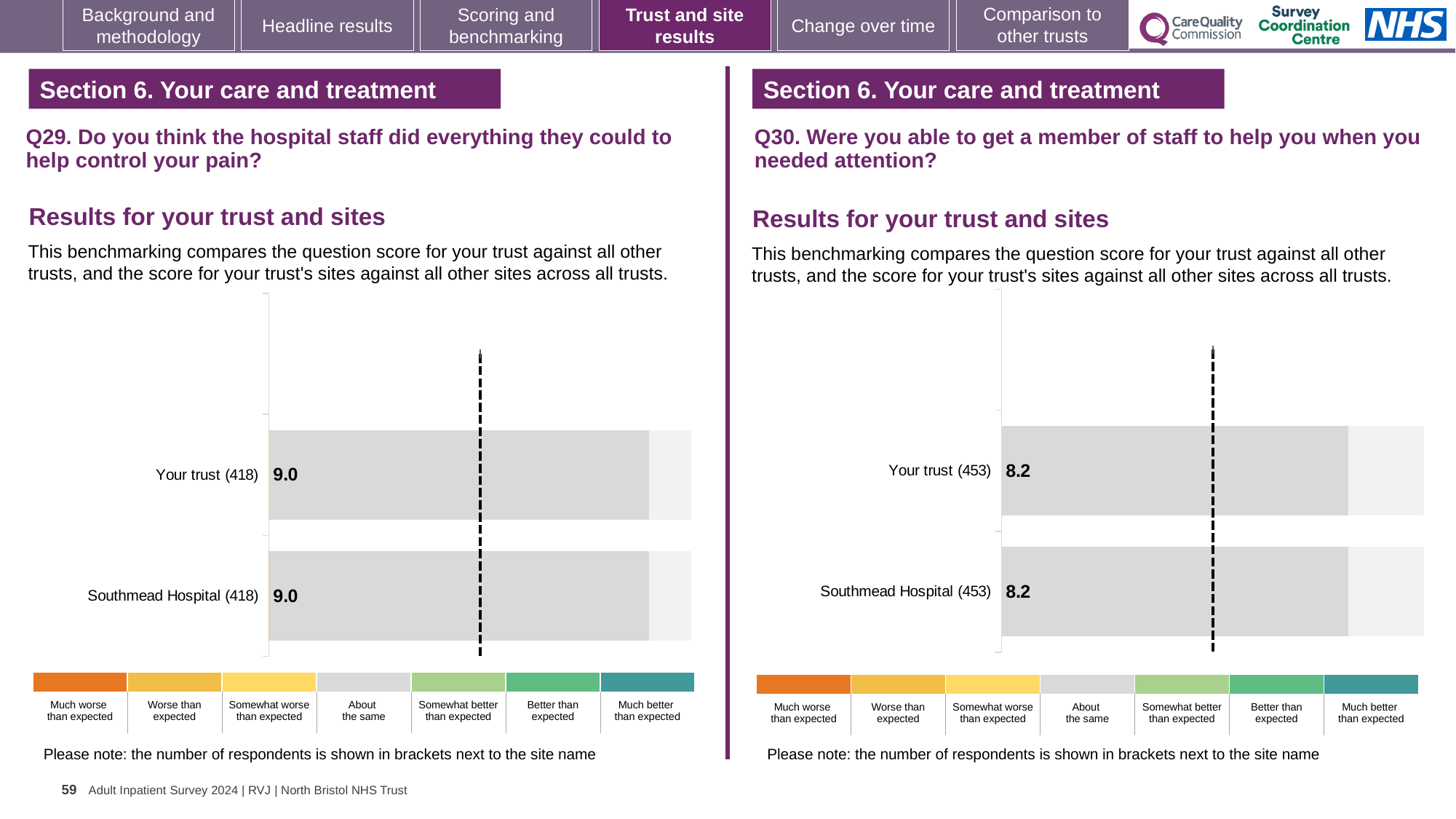
In the Q29 chart on the left, how many respondents are shown in brackets next to Southmead Hospital? 418 In the Q29 chart on the left, what is the score for Southmead Hospital? 9.0 How many bars are plotted in the Q30 chart on the right? 2 In the Q29 chart on the left, what is the difference between the score for Your trust and the score for Southmead Hospital? 0.0 What kind of chart is used for the Q30 results on the right? Bar chart In the Q29 chart on the left, what is the score for Your trust? 9.0 How many bars are plotted in the Q29 chart on the left? 2 In the Q30 chart on the right, how many respondents are shown in brackets next to Your trust? 453 In the Q30 chart on the right, what is the score for Southmead Hospital? 8.2 In the colour key below the Q30 chart on the right, what does the middle grey band represent? About the same In the Q30 chart on the right, what is the score for Your trust? 8.2 Which question does the chart on the left of the slide relate to? Q29. Do you think the hospital staff did everything they could to help control your pain?